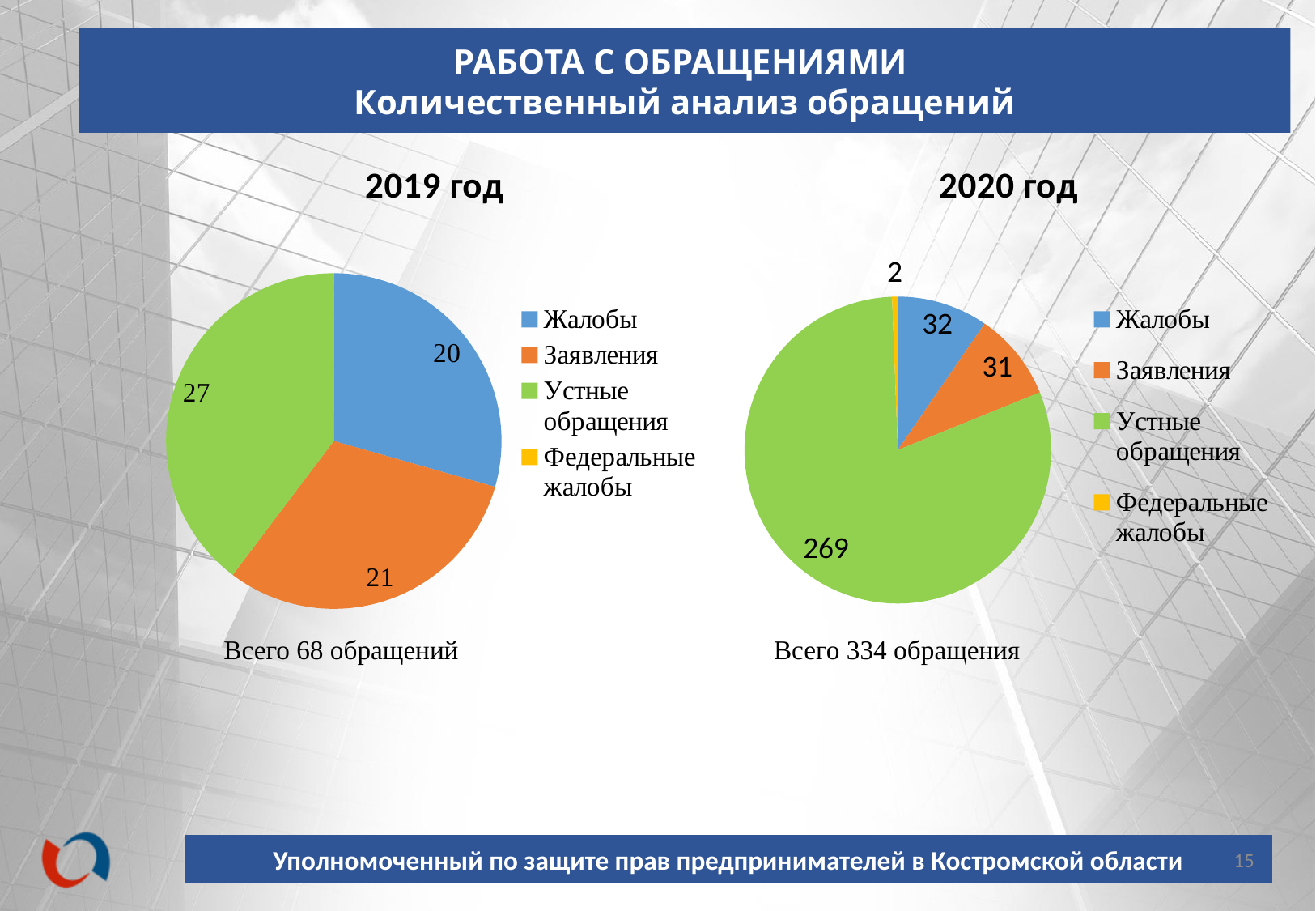
How many entries does the legend of the 2020 год chart list? 4 What total number of обращения is stated below the 2019 год chart? 68 In the 2020 год chart, which is larger, Жалобы or Заявления? Жалобы In the 2019 год chart, which category has the largest slice? Устные обращения In the 2020 год chart, what is the value for Федеральные жалобы? 2 In the 2020 год chart, what is the difference between Устные обращения and Жалобы? 237 In the 2020 год chart, which category has the smallest slice? Федеральные жалобы What kind of chart is used for the 2019 год data? Pie chart In the 2020 год chart, what is the value for Устные обращения? 269 In the 2019 год chart, what is the value for Жалобы? 20 In the 2020 год chart, what share of the total of 334 does Устные обращения (269) represent, to the nearest whole percent? 81% In the 2019 год chart, what is the difference between Устные обращения and Заявления? 6